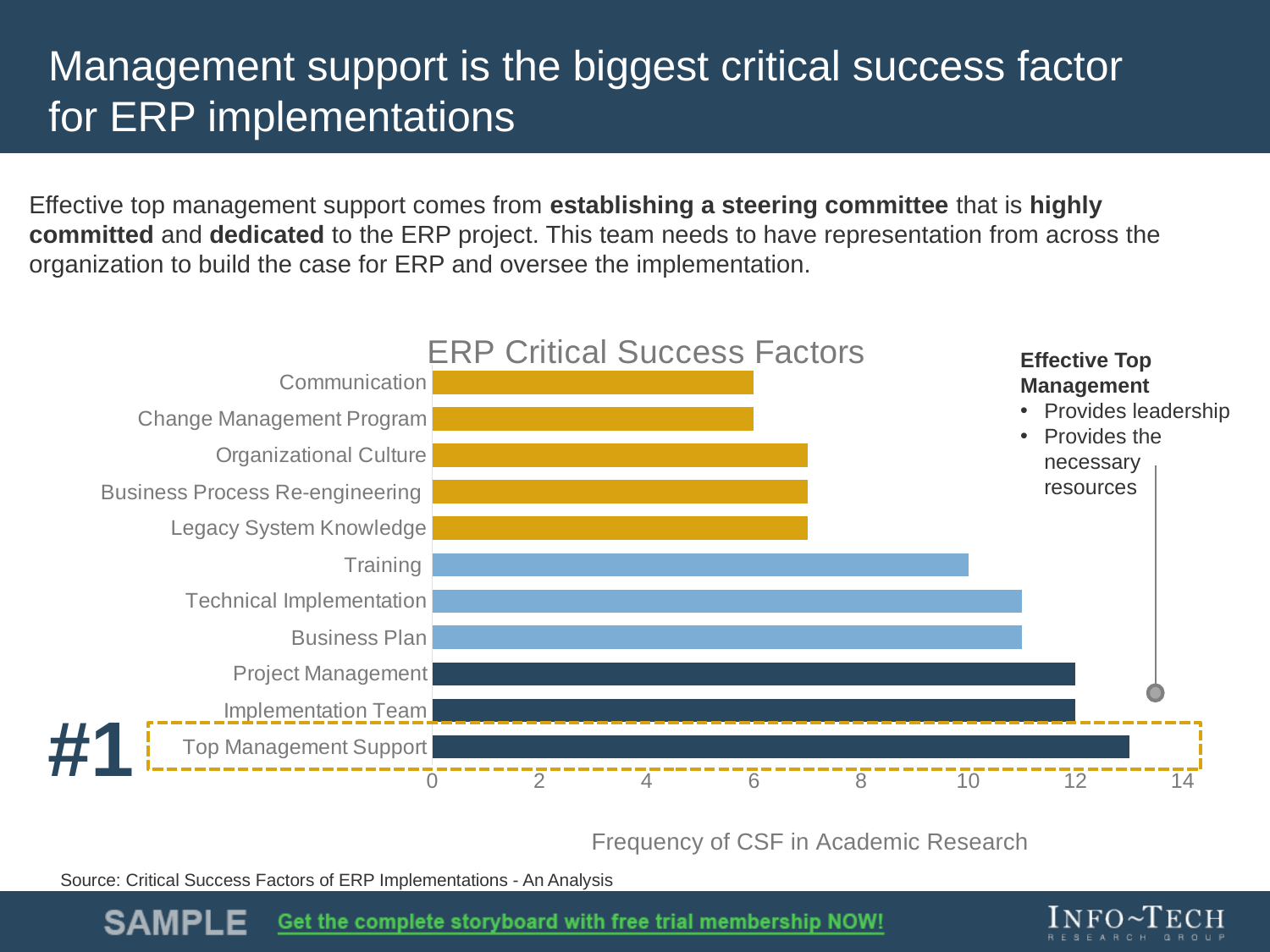
What type of chart is shown on the slide? bar chart Is the value for Top Management Support greater or less than 12? greater Is the value for Organizational Culture greater or less than 6? greater Which category has the highest value in the chart? Top Management Support What is the title of the chart? ERP Critical Success Factors What is the difference between the value for Project Management and the value for Communication? 6 What is the value for Project Management? 12 What is the value for Communication? 6 What is the value for Implementation Team? 12 What is the value for Training? 10 How many categories are plotted in the chart? 11 Which is larger, the value for Training or the value for Change Management Program? Training